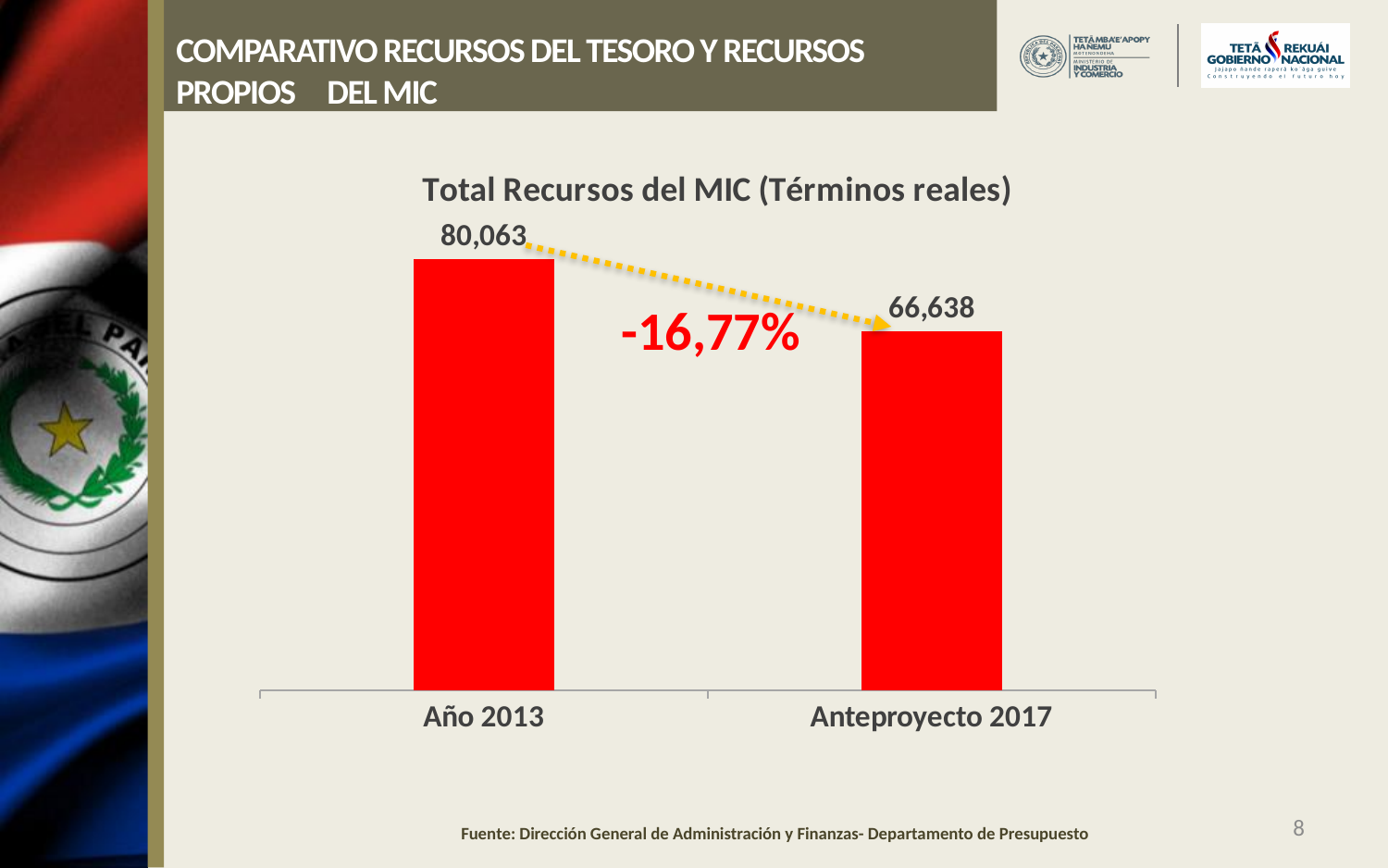
What is the difference between the value for Año 2013 and the value for Anteproyecto 2017? 13,425 What is the value for Año 2013? 80,063 What percentage change is annotated between the two bars? -16,77% How many categories are shown in the chart? 2 Which is larger, the value for Año 2013 or the value for Anteproyecto 2017? Año 2013 Which category has the highest value? Año 2013 What is the value for Anteproyecto 2017? 66,638 What kind of chart is shown on the slide? Bar chart What is the title of the chart? Total Recursos del MIC (Términos reales) Do the values rise or fall from Año 2013 to Anteproyecto 2017? Fall Which category has the lowest value? Anteproyecto 2017